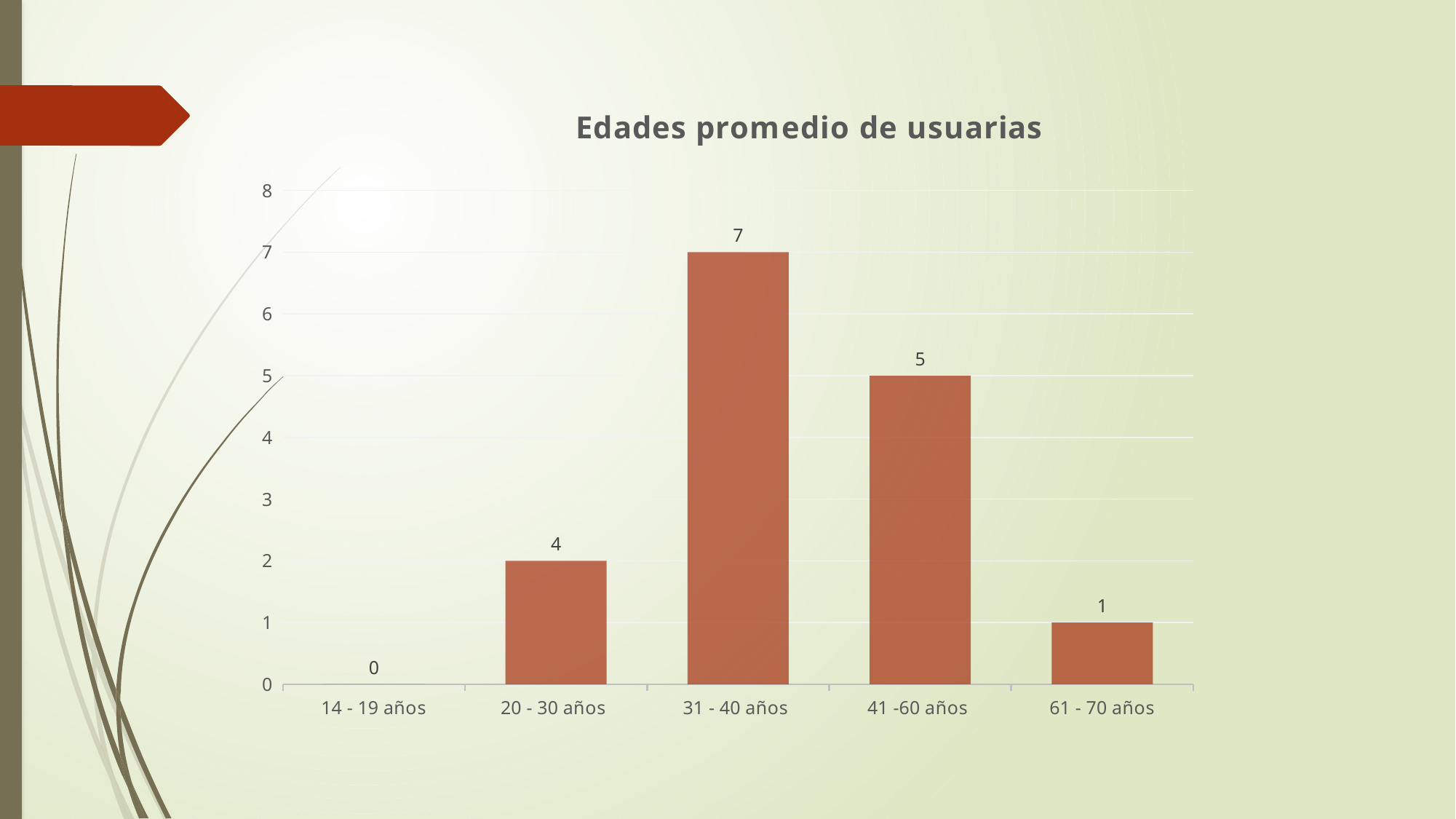
Is the value for 41 -60 años greater or less than 4? greater What is the value for 31 - 40 años? 7 What is the difference between the values for 31 - 40 años and 41 -60 años? 2 Which age group has the highest value? 31 - 40 años Which age group has the lowest value? 14 - 19 años What is the value for 61 - 70 años? 1 What kind of chart is shown on the slide? bar chart Which is larger, the value for 20 - 30 años or the value for 61 - 70 años? 20 - 30 años How many age groups are shown on the x axis? 5 What is the title of the chart? Edades promedio de usuarias What is the value for 14 - 19 años? 0